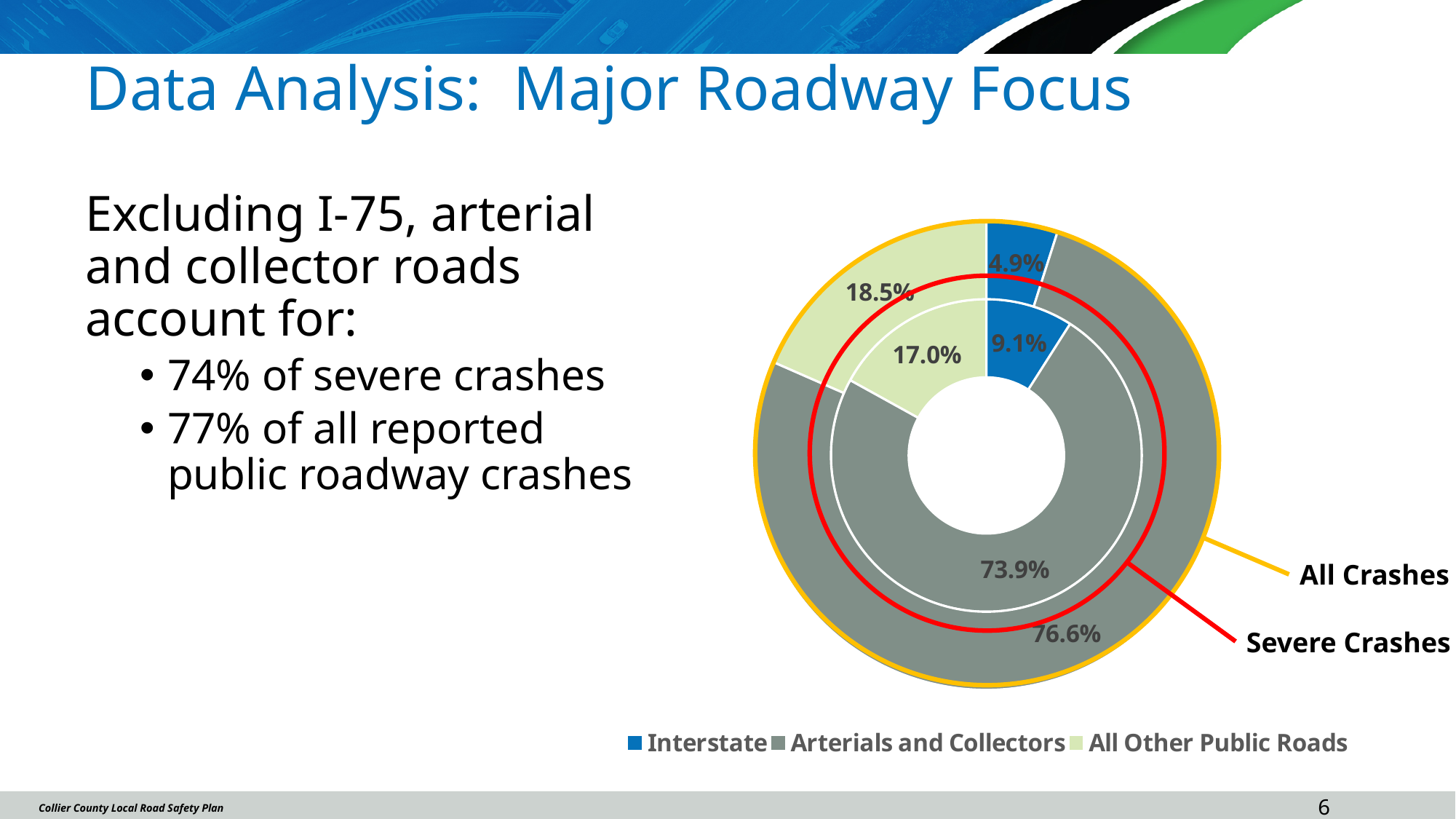
Is the Arterials and Collectors share larger in the All Crashes ring or the Severe Crashes ring? All Crashes What kind of chart is shown on the slide? Doughnut chart Which ring of the doughnut chart represents Severe Crashes, the inner or the outer? Inner In the All Crashes ring, what share is Arterials and Collectors? 76.6% In the Severe Crashes ring, what share is Interstate? 9.1% In the All Crashes ring, what share is Interstate? 4.9% Which category has the largest share in the Severe Crashes ring? Arterials and Collectors In the Severe Crashes ring, what share is All Other Public Roads? 17.0% How many categories does the legend list? 3 Which category has the smallest share in the All Crashes ring? Interstate In the All Crashes ring, what share is All Other Public Roads? 18.5% What is the difference between the Interstate share of Severe Crashes and the Interstate share of All Crashes? 4.2%